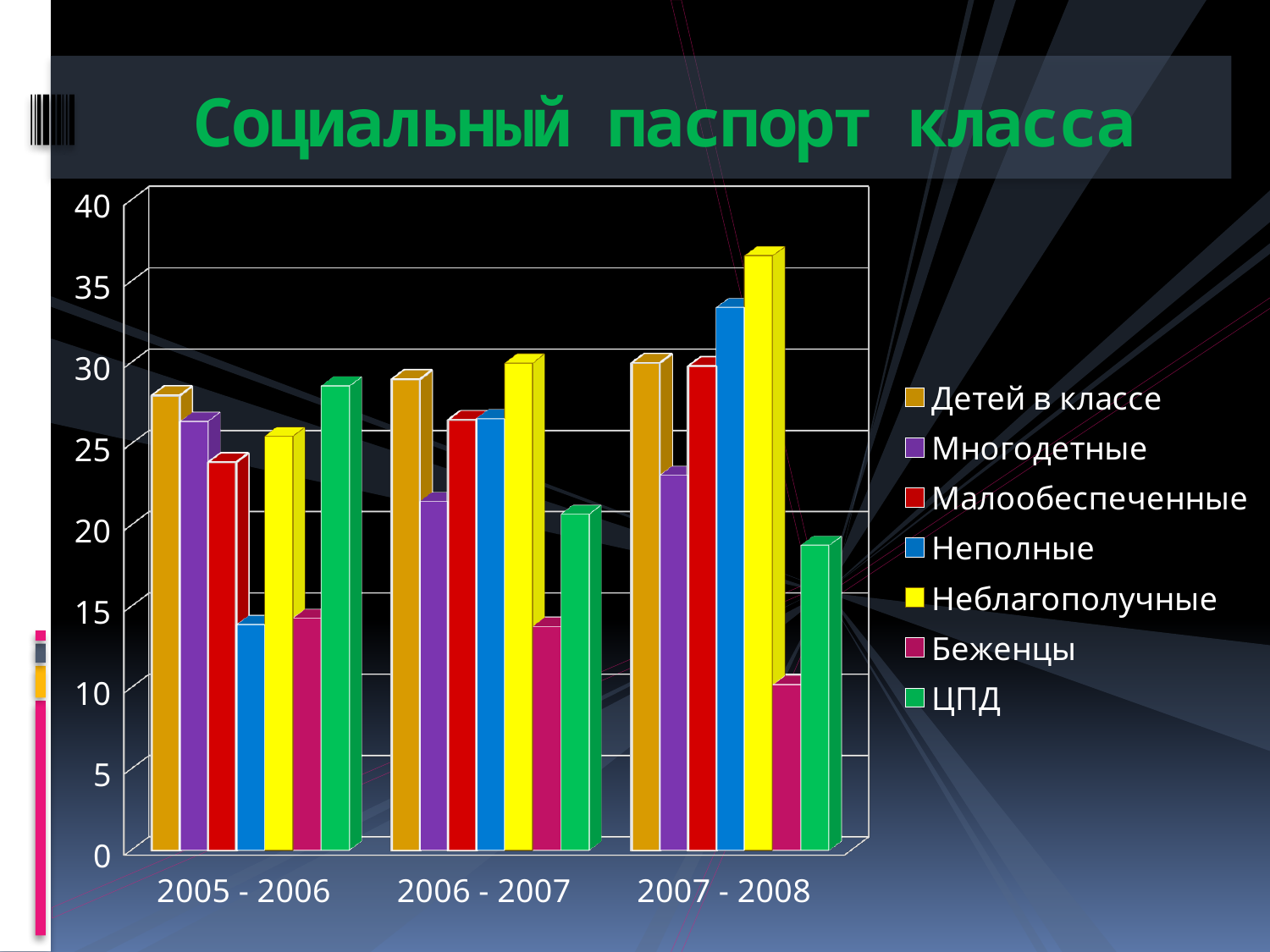
Which series is shown in yellow in the legend? Неблагополучные Do the values for Неполные rise or fall from 2005 - 2006 to 2007 - 2008? rise How many school-year categories are shown on the x axis? 3 Is the value for Неблагополучные in 2007 - 2008 greater or less than 30? greater Is the value for Беженцы in 2007 - 2008 greater or less than 15? less Which series has the tallest bar in the 2007 - 2008 group? Неблагополучные Which is larger in 2007 - 2008: Неполные or Беженцы? Неполные What is the title of the slide? Социальный паспорт класса Is the value for Неполные in 2005 - 2006 greater or less than 20? less How many series does the legend list? 7 What kind of chart is shown on the slide? bar chart Which series has the shortest bar in the 2007 - 2008 group? Беженцы